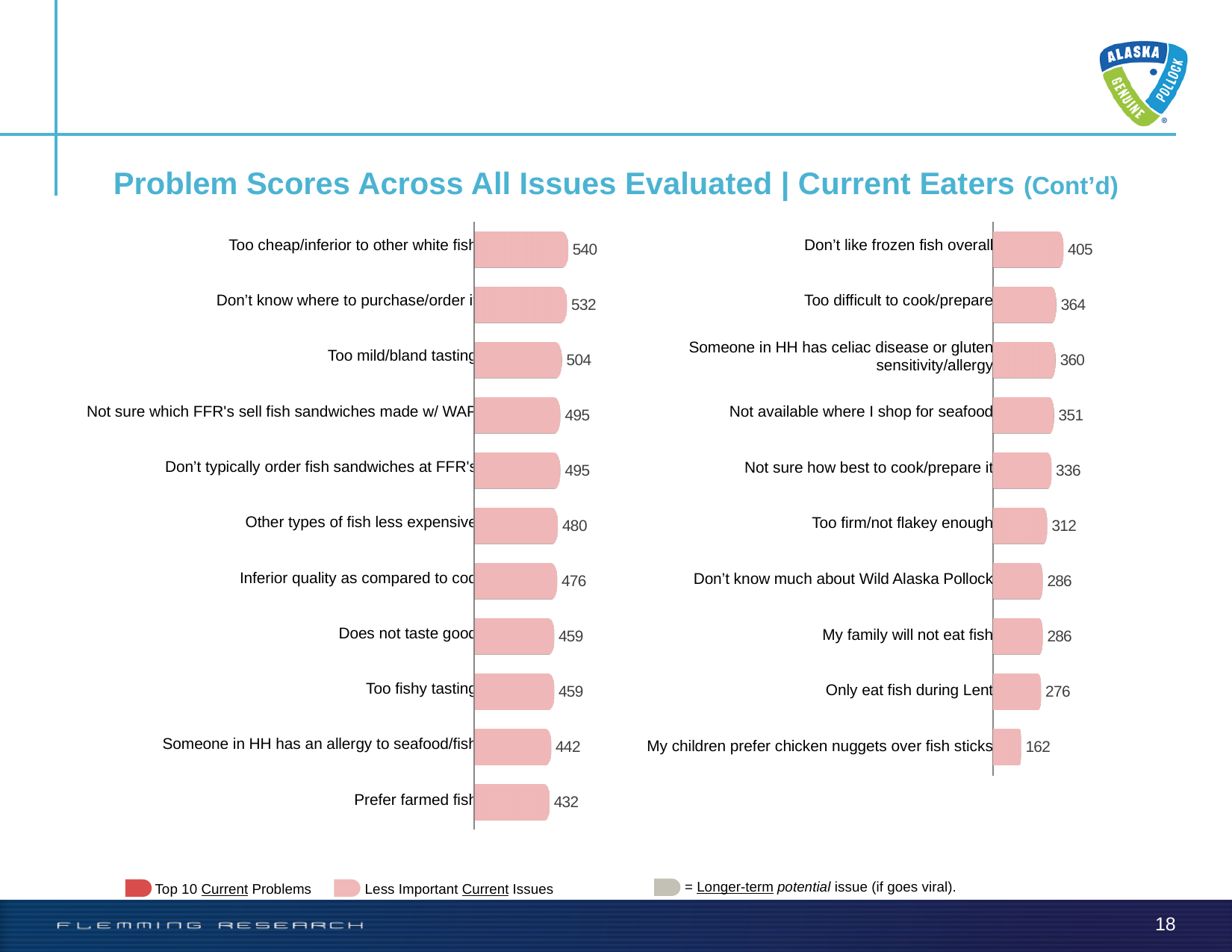
On the left chart, what is the difference between the scores for "Too cheap/inferior to other white fish" and "Prefer farmed fish"? 108 On the left chart, which issue has the highest problem score? Too cheap/inferior to other white fish On the right chart, which issue has the lowest problem score? My children prefer chicken nuggets over fish sticks On the left chart, what is the problem score for "Prefer farmed fish"? 432 How many issues are plotted on the left chart? 11 On the right chart, what is the problem score for "Too difficult to cook/prepare"? 364 What type of chart is used on this slide? Bar chart On the right chart, what is the problem score for "Only eat fish during Lent"? 276 On the right chart, which has a higher score: "Not available where I shop for seafood" or "My family will not eat fish"? Not available where I shop for seafood On the left chart, what is the problem score for "Too mild/bland tasting"? 504 On the right chart, what is the difference between the scores for "Don't like frozen fish overall" and "Too firm/not flakey enough"? 93 How many issues are plotted on the right chart? 10